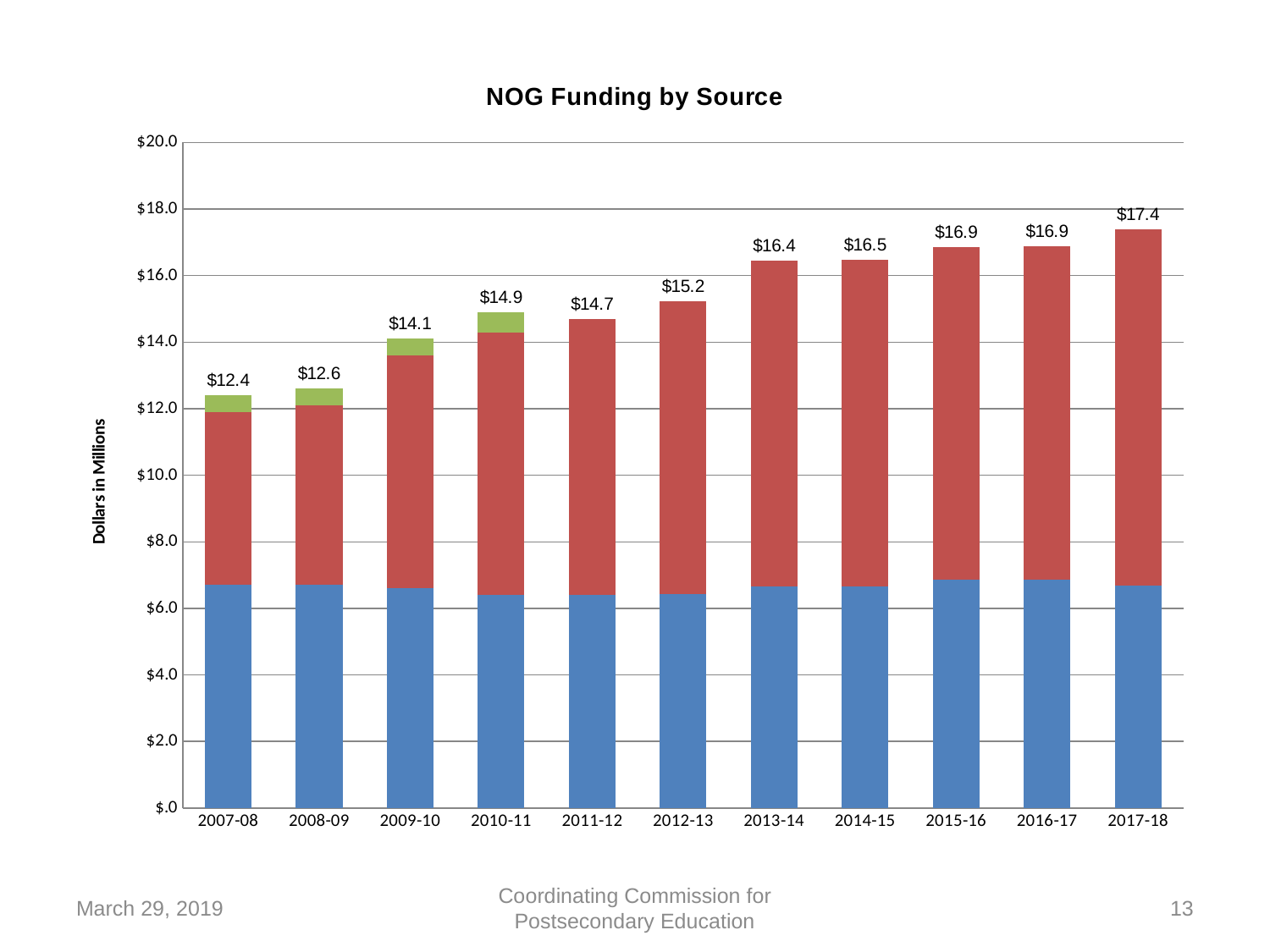
Do the total funding values generally rise or fall from 2007-08 to 2017-18? Rise What is the total NOG funding shown for 2017-18? $17.4 What is the label on the vertical axis of the chart? Dollars in Millions What is the difference between the total funding in 2017-18 and in 2007-08? $5.0 Is the value of the blue segment for 2007-08 greater or less than $8.0? less How many years are shown on the x axis? 11 Which year has a larger total funding, 2010-11 or 2011-12? 2010-11 What is the total NOG funding shown for 2012-13? $15.2 Which year has the lowest total NOG funding? 2007-08 What kind of chart is shown on the slide? Stacked bar chart What is the total NOG funding shown for 2009-10? $14.1 Which year has the highest total NOG funding? 2017-18